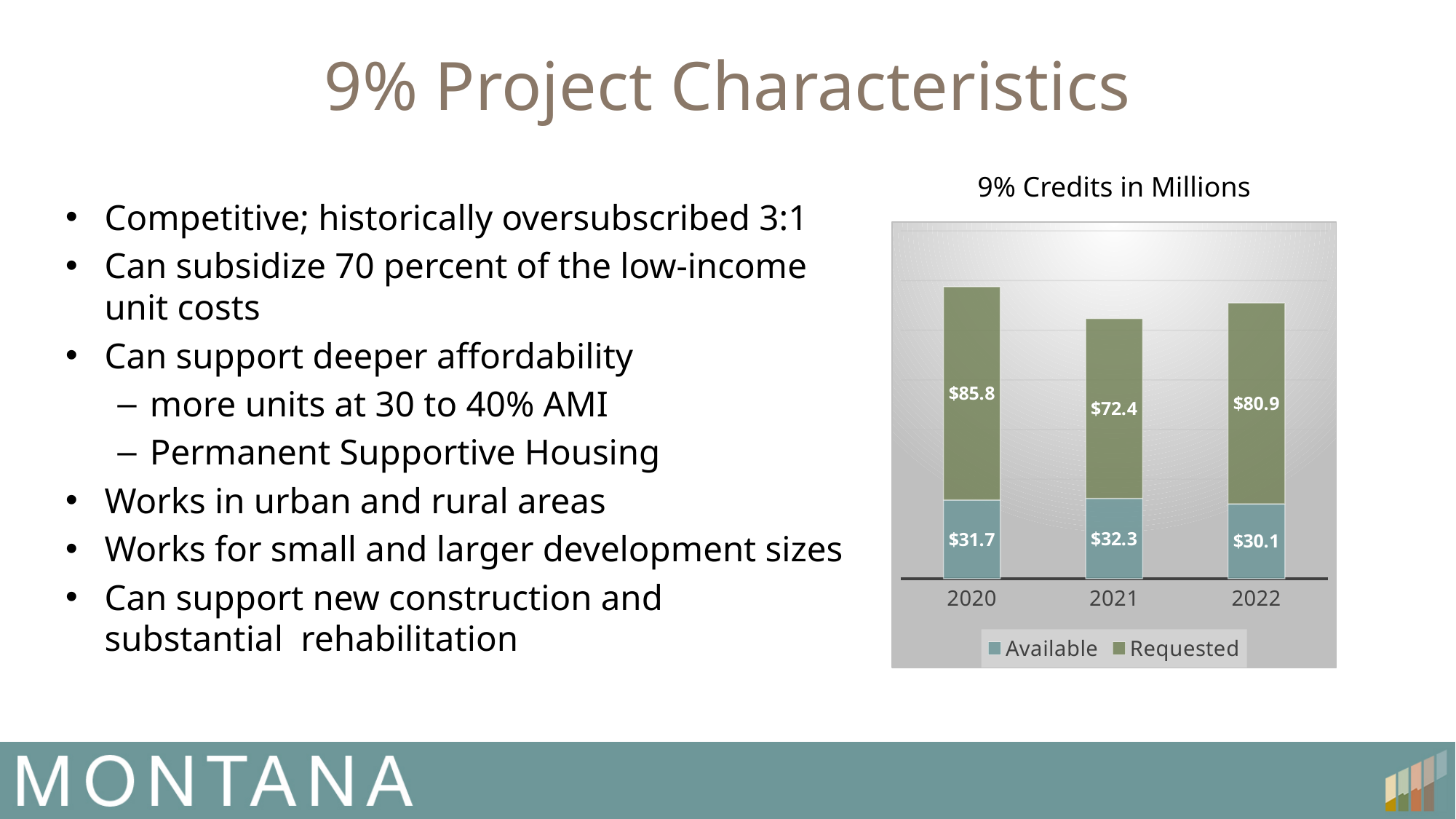
What is the total of the stacked bar for 2021? $104.7 What was the Requested value in 2020? $85.8 In which year was the Requested value lowest? 2021 What was the Available value in 2022? $30.1 What is the title of the chart on the slide? 9% Credits in Millions What was the Available value in 2021? $32.3 Which is larger, the Requested value in 2021 or the Requested value in 2022? 2022 What type of chart is shown on the slide? Stacked bar chart How many years are shown on the x axis of the chart? 3 What is the difference between the Requested and Available values in 2022? $50.8 How many series does the chart's legend list? 2 In which year was the Requested value highest? 2020